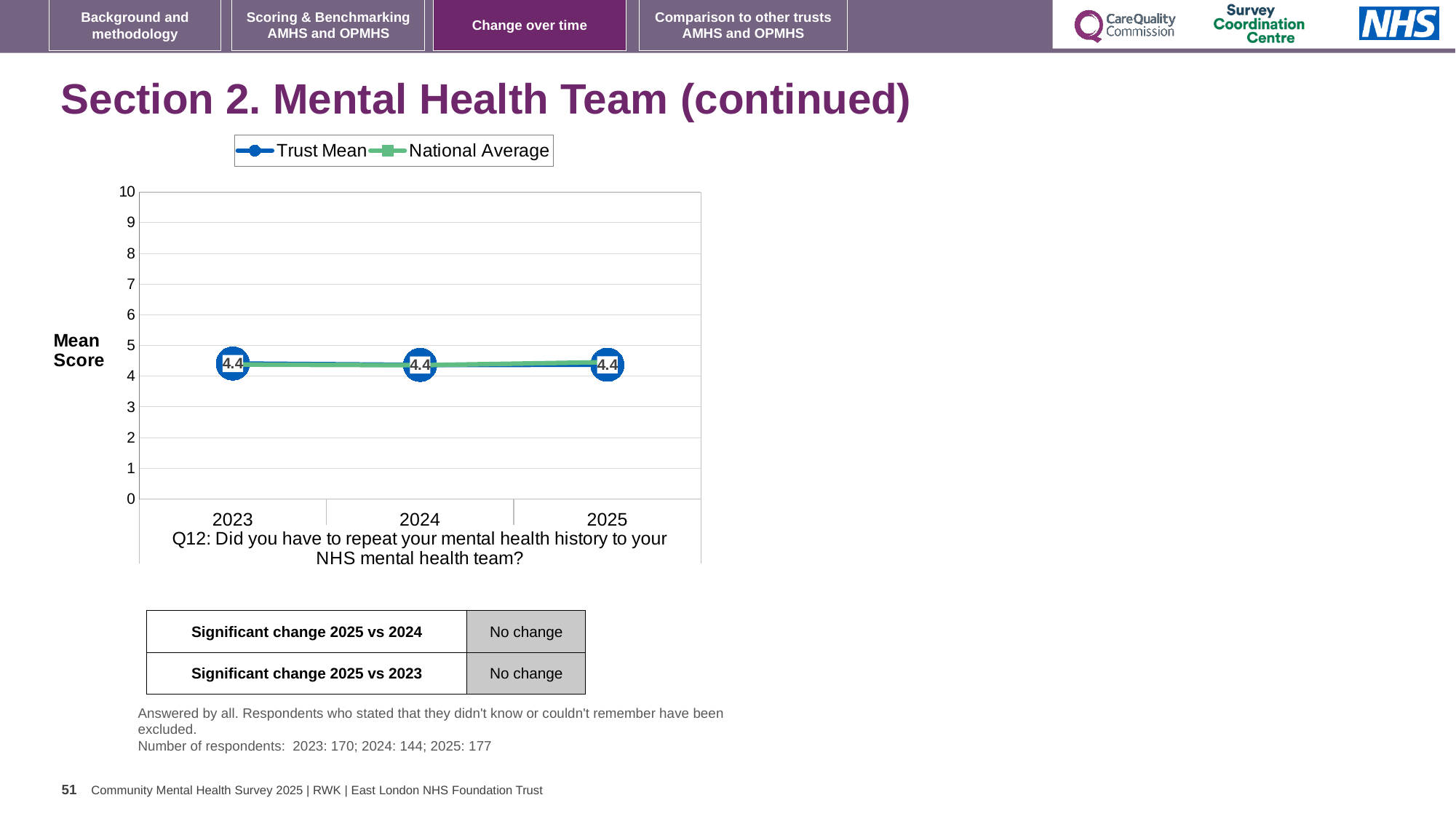
Is the National Average value for 2025 greater or less than 4? greater What is the Trust Mean score for 2025? 4.4 Is the National Average value for 2023 greater or less than 6? less How many series does the legend list? 2 Is the Trust Mean value for 2024 greater or less than 5? less What is the Trust Mean score for 2023? 4.4 What is the label of the y axis? Mean Score What is the difference between the Trust Mean score in 2025 and in 2023? 0 What kind of chart is shown on the slide? line chart How many years are plotted on the x axis? 3 What is the Trust Mean score for 2024? 4.4 Does the Trust Mean rise, fall or stay flat from 2023 to 2025? stays flat